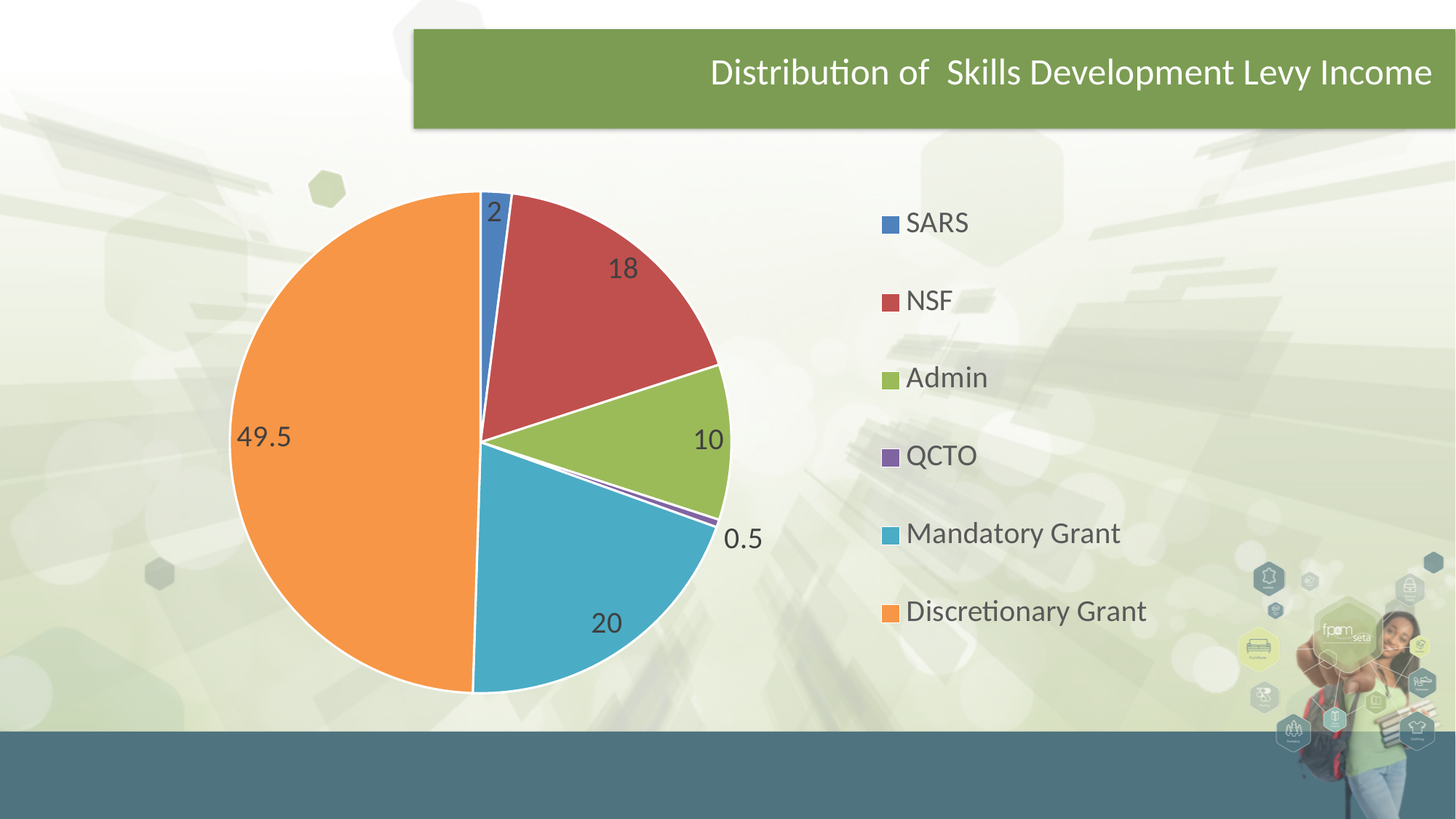
What is the title of the chart? Distribution of Skills Development Levy Income How many categories does the pie chart have? 6 What is the value for Mandatory Grant? 20 What is the difference between the values for Mandatory Grant and Admin? 10 What kind of chart is shown on the slide? pie chart What colour is the Admin slice? green Which category has the smallest slice? QCTO What is the value for QCTO? 0.5 What is the value for NSF? 18 Which category has the largest slice? Discretionary Grant What is the value for Discretionary Grant? 49.5 Which is larger, the value for NSF or the value for SARS? NSF